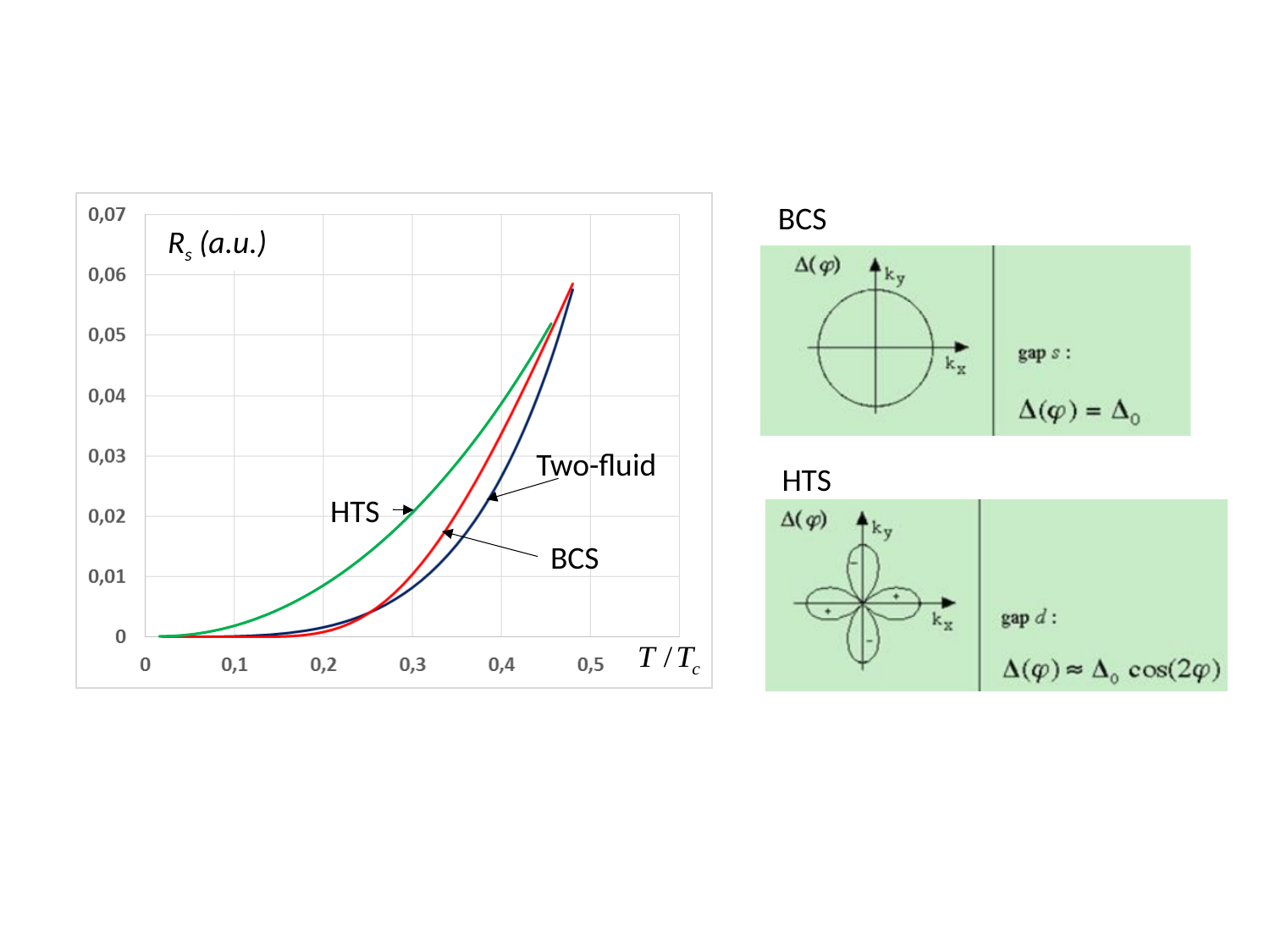
What are the names of the three curves in the chart? HTS, Two-fluid, BCS Which curve has the highest Rs value at T/Tc = 0.3? HTS Is the Two-fluid value at T/Tc = 0.4 greater or less than 0,03? less Is the HTS value at T/Tc = 0.4 greater or less than 0,03? greater What kind of chart is shown on the left of the slide? line chart At T/Tc = 0.3, which curve is higher, HTS or Two-fluid? HTS Do the curves in the chart rise or fall as T/Tc increases? rise How many curves are plotted in the chart on the left? 3 What is the label of the vertical axis of the chart? Rs (a.u.) Which curve has the lowest Rs value at T/Tc = 0.4? Two-fluid At T/Tc = 0.4, which curve is higher, HTS or BCS? HTS Is the HTS value at T/Tc = 0.2 greater or less than 0,01? less